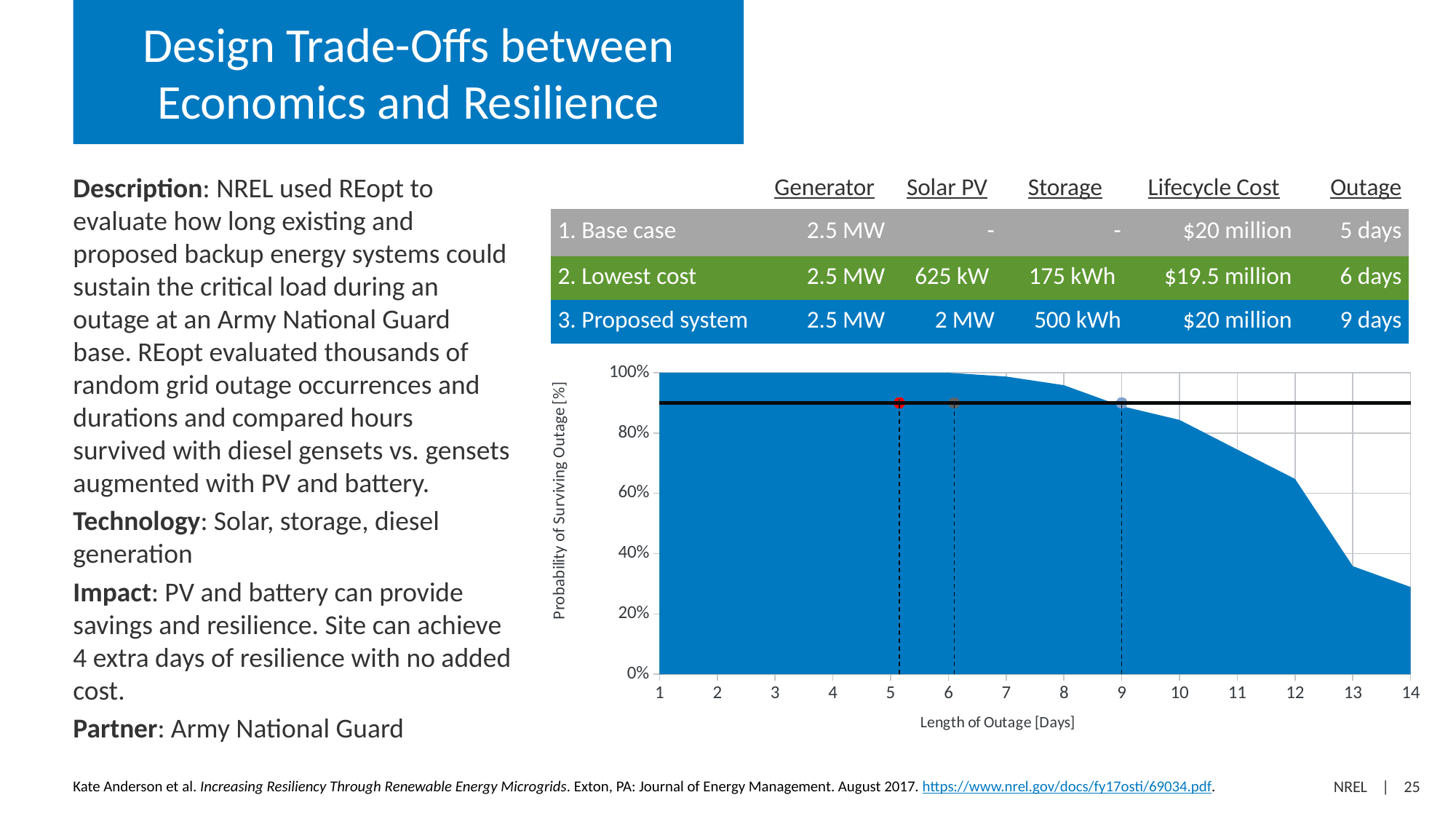
Is the probability of surviving an outage at 13 days greater or less than 60%? less What kind of chart is shown on the slide? area chart How many day values are marked on the x axis of the chart? 14 Which has a higher probability of surviving the outage: 9 days or 12 days? 9 days Is the probability of surviving an outage at 10 days greater or less than 80%? greater At which length of outage is the probability of surviving the outage lowest? 14 Is the probability of surviving an outage at 14 days greater or less than 40%? less Does the probability of surviving an outage rise or fall as the length of outage increases? fall What is the label of the x axis of the chart? Length of Outage [Days] What is the label of the y axis of the chart? Probability of Surviving Outage [%] What is the highest value shown on the y axis of the chart? 100%